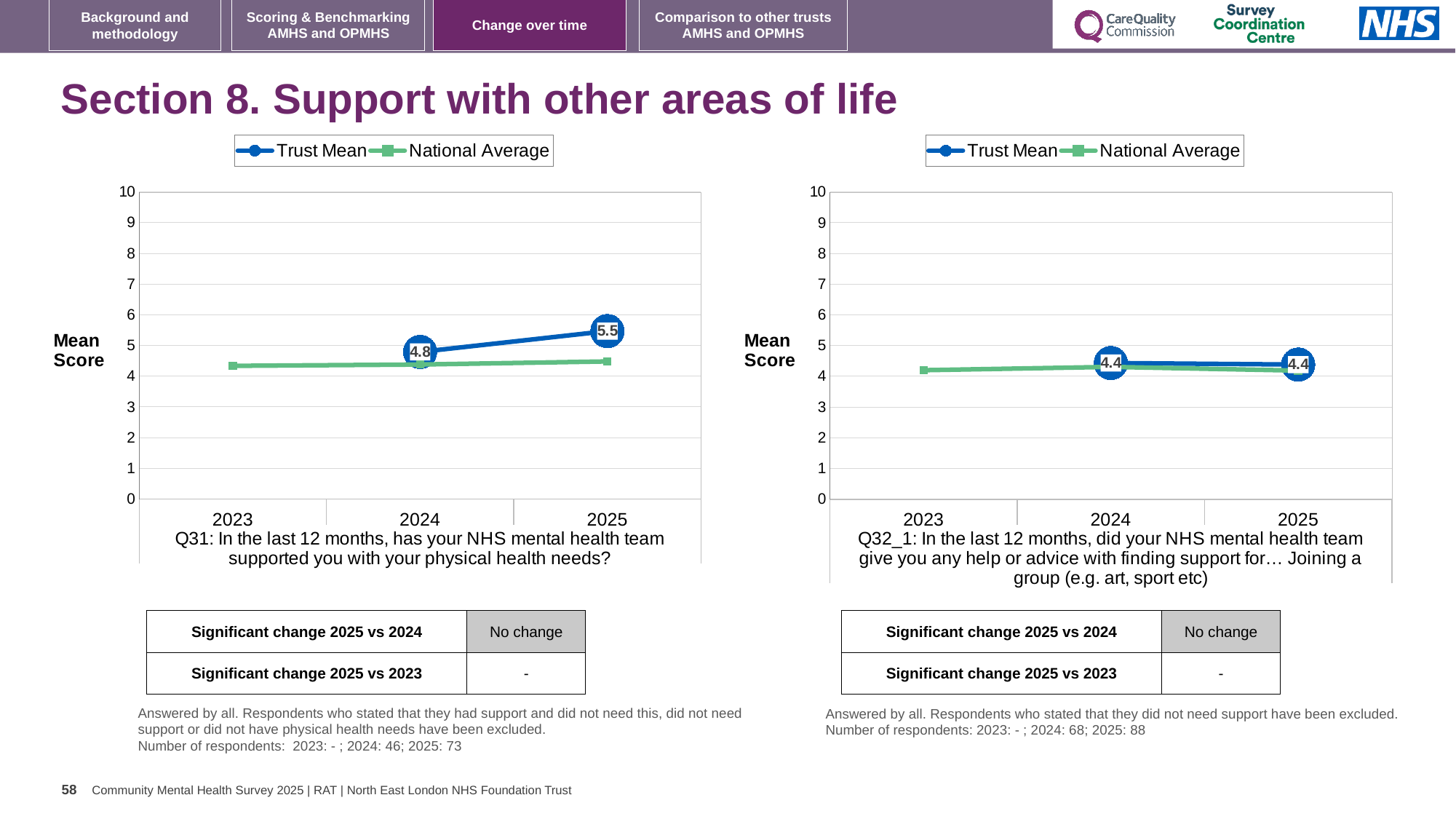
On the right chart (Q32_1), is the National Average for 2023 greater or less than 5? less On the left chart (Q31), what is the Trust Mean for 2025? 5.5 On the left chart (Q31), does the Trust Mean rise or fall from 2024 to 2025? rise What kind of chart is the right chart (Q32_1)? line chart How many years are shown on the x axis of the left chart (Q31)? 3 On the left chart (Q31), what is the Trust Mean for 2024? 4.8 On the left chart (Q31), which year has the higher Trust Mean, 2024 or 2025? 2025 On the left chart (Q31), by how much did the Trust Mean change from 2024 to 2025? 0.7 On the right chart (Q32_1), what is the Trust Mean for 2024? 4.4 On the right chart (Q32_1), what is the Trust Mean for 2025? 4.4 On the left chart (Q31), is the National Average for 2025 greater or less than 5? less How many series does the legend of the right chart (Q32_1) list? 2